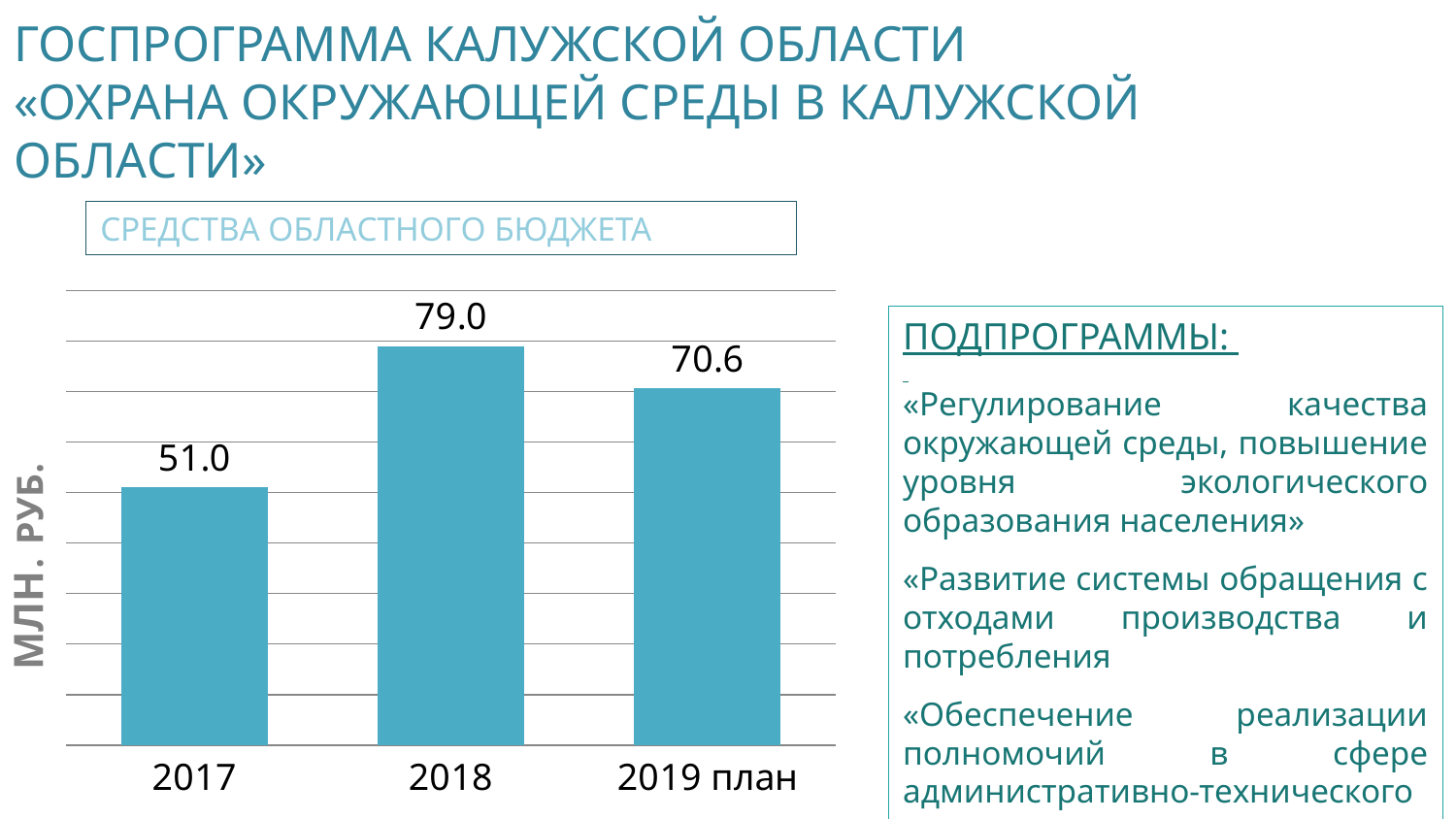
Which is larger, the value for 2019 план or the value for 2017? 2019 план What is the difference between the values for 2018 and 2017? 28.0 What is the title of the chart? СРЕДСТВА ОБЛАСТНОГО БЮДЖЕТА What is the label on the vertical axis of the chart? МЛН. РУБ. What is the value for 2019 план? 70.6 What is the difference between the values for 2018 and 2019 план? 8.4 Which year has the highest value? 2018 How many bars are shown in the chart? 3 What is the value for 2017? 51.0 Which year has the lowest value? 2017 What kind of chart is shown on the slide? bar chart What is the value for 2018? 79.0